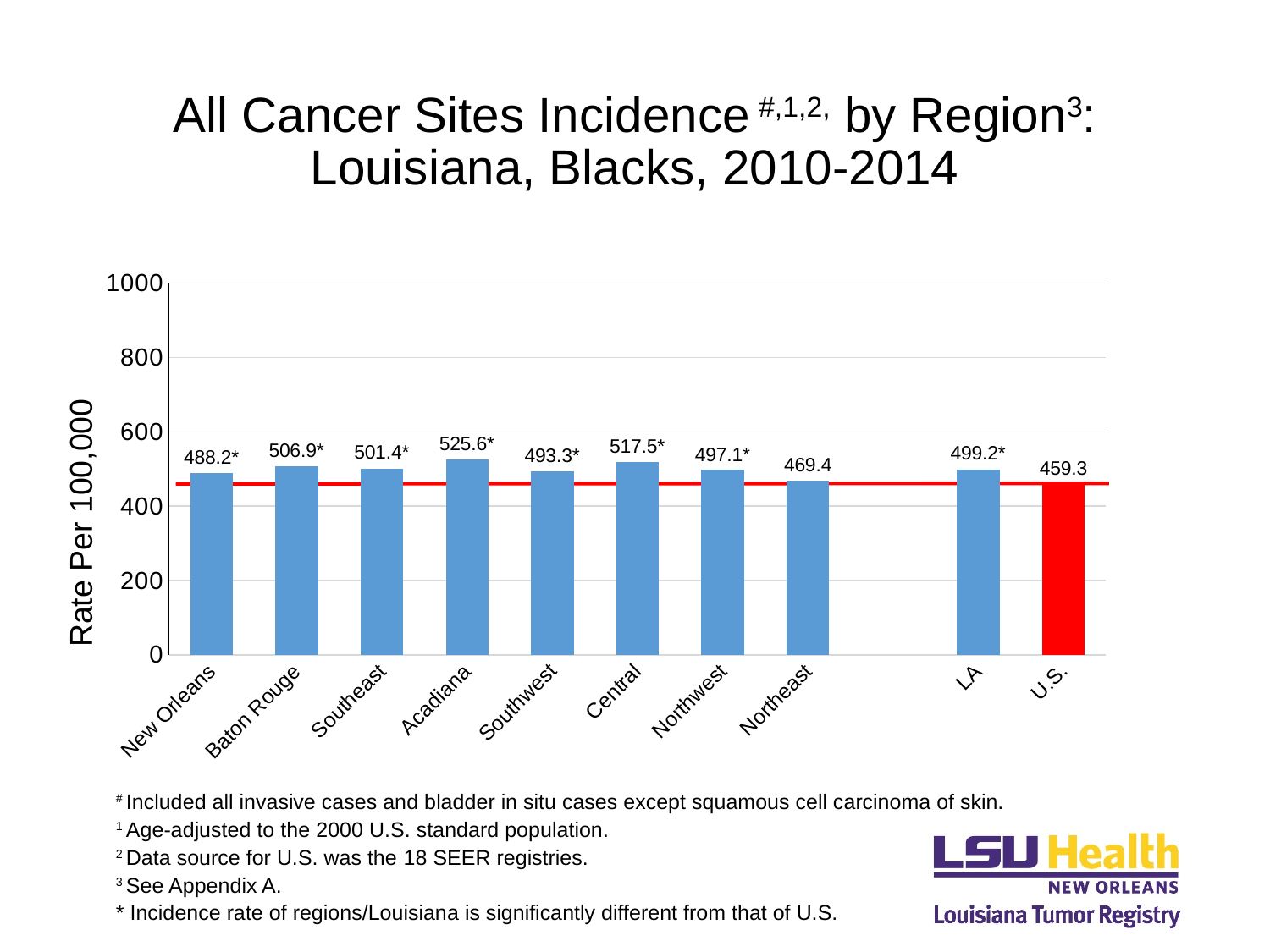
Is the value for Central greater or less than 600? less What kind of chart is shown on the slide? Bar chart What is the rate per 100,000 for Northeast? 469.4 Which category has the highest rate? Acadiana How many bars are shown in the chart? 10 What is the rate per 100,000 for LA? 499.2* What is the rate per 100,000 for the U.S.? 459.3 What is the rate per 100,000 for Acadiana? 525.6* What is the difference between the Acadiana rate and the U.S. rate? 66.3 What is the difference between the Central rate and the Northeast rate? 48.1 Which has a higher rate, Baton Rouge or New Orleans? Baton Rouge Which category has the lowest rate? U.S.